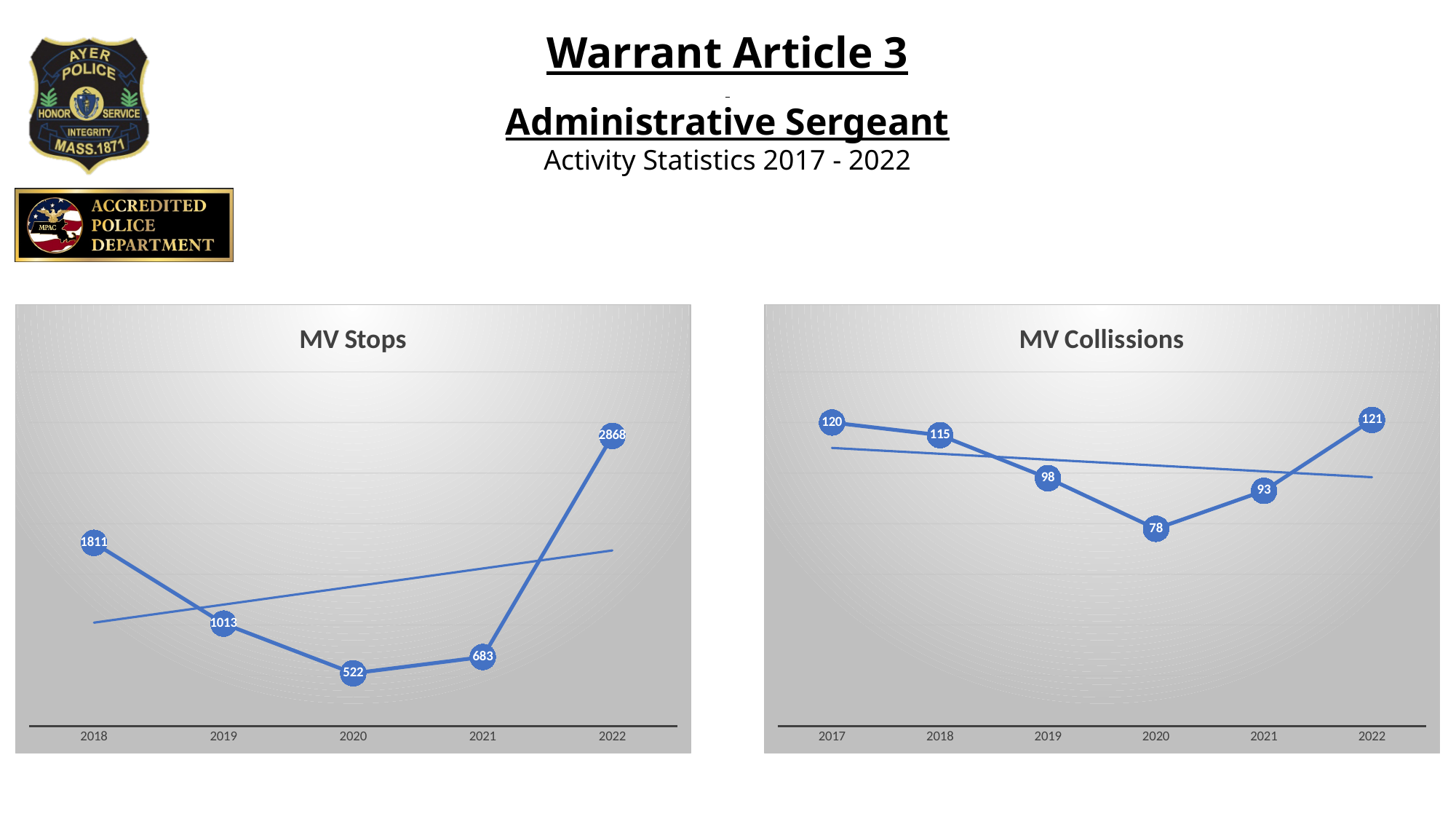
In the MV Stops chart, which year has the highest value? 2022 In the MV Stops chart, what is the difference between the 2022 value and the 2018 value? 1057 In the MV Stops chart, what is the value for 2020? 522 In the MV Collissions chart, do the values rise or fall from 2017 to 2020? fall What kind of chart is the MV Stops chart? line chart In the MV Collissions chart, which year has the lowest value? 2020 In the MV Stops chart, how many years are plotted? 5 In the MV Stops chart, which year has the lowest value? 2020 In the MV Collissions chart, what is the difference between the 2017 value and the 2018 value? 5 In the MV Collissions chart, which is larger, the value for 2019 or the value for 2021? 2019 In the MV Collissions chart, what is the value for 2020? 78 In the MV Collissions chart, which year has the highest value? 2022